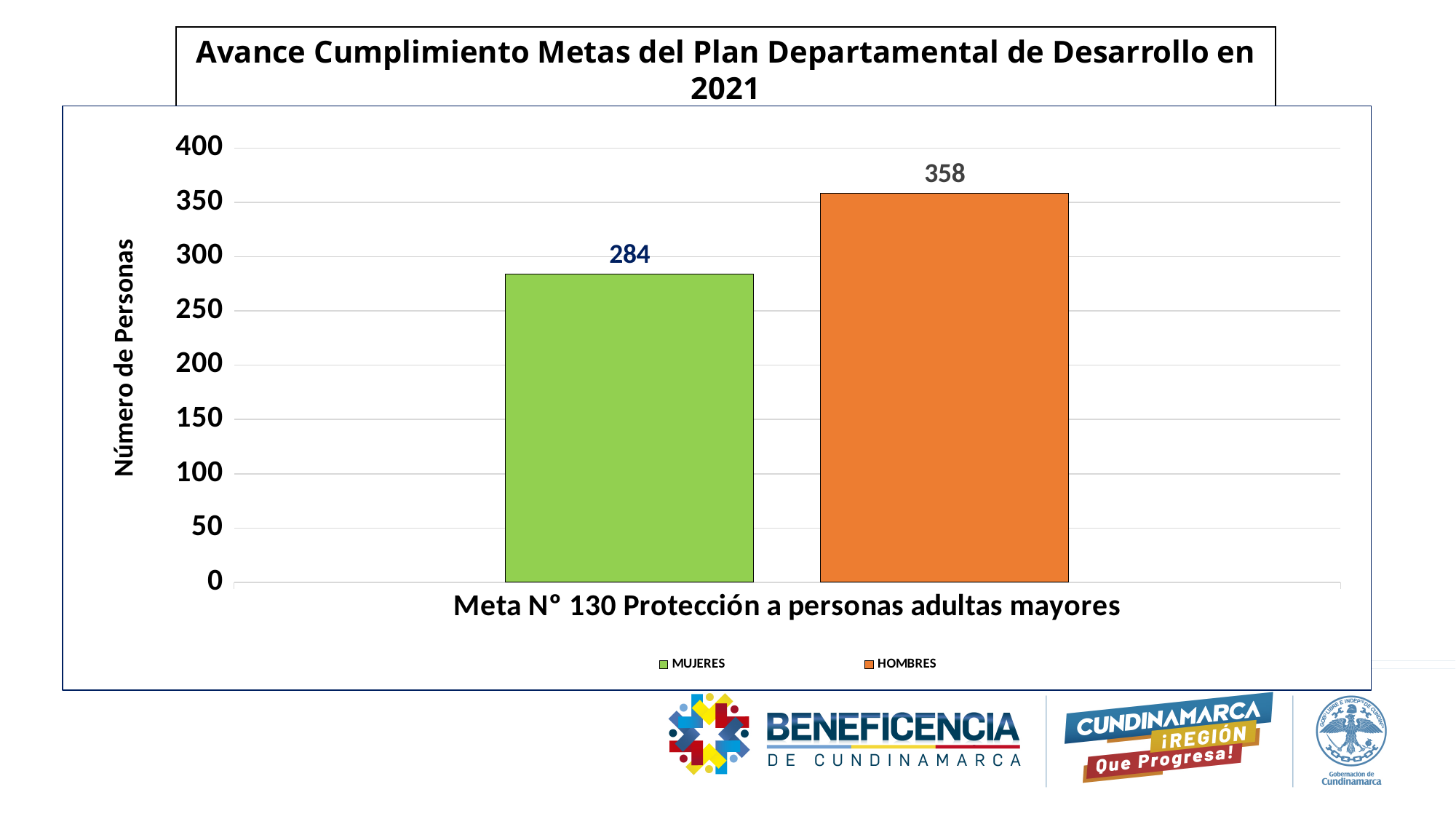
Which series has the highest value? HOMBRES Is the value for MUJERES greater or less than 300? less What is the label of the vertical axis? Número de Personas What is the value for MUJERES? 284 Is the value for HOMBRES greater or less than 350? greater What is the difference between the values for HOMBRES and MUJERES? 74 What is the value for HOMBRES? 358 What kind of chart is shown on the slide? bar chart How many series does the legend list? 2 Which is larger, the value for MUJERES or the value for HOMBRES? HOMBRES Which series has the lowest value? MUJERES What colour is the bar for HOMBRES? orange